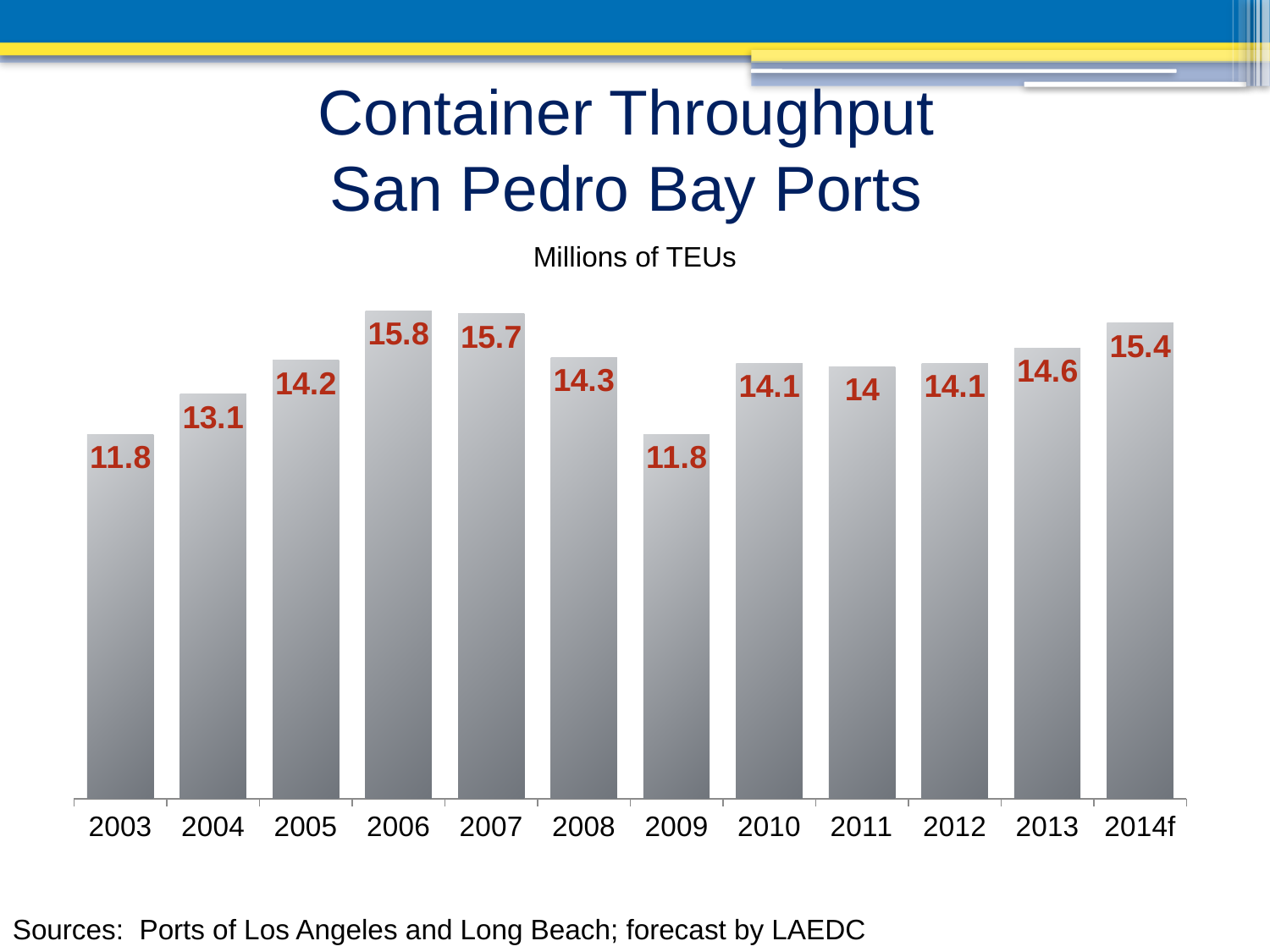
Which year has the highest container throughput? 2006 How many years are shown on the x axis? 12 What is the container throughput value for 2013? 14.6 What is the container throughput value for 2006? 15.8 What kind of chart is shown on the slide? Bar chart What is the difference between the 2007 value and the 2009 value? 3.9 Do the values rise or fall from 2009 to 2010? Rise Which is larger, the value for 2005 or the value for 2008? 2008 What is the difference between the 2014f value and the 2013 value? 0.8 What is the forecast value shown for 2014f? 15.4 What unit is the chart measured in, according to the subtitle? Millions of TEUs Which is larger, the value for 2004 or the value for 2011? 2011